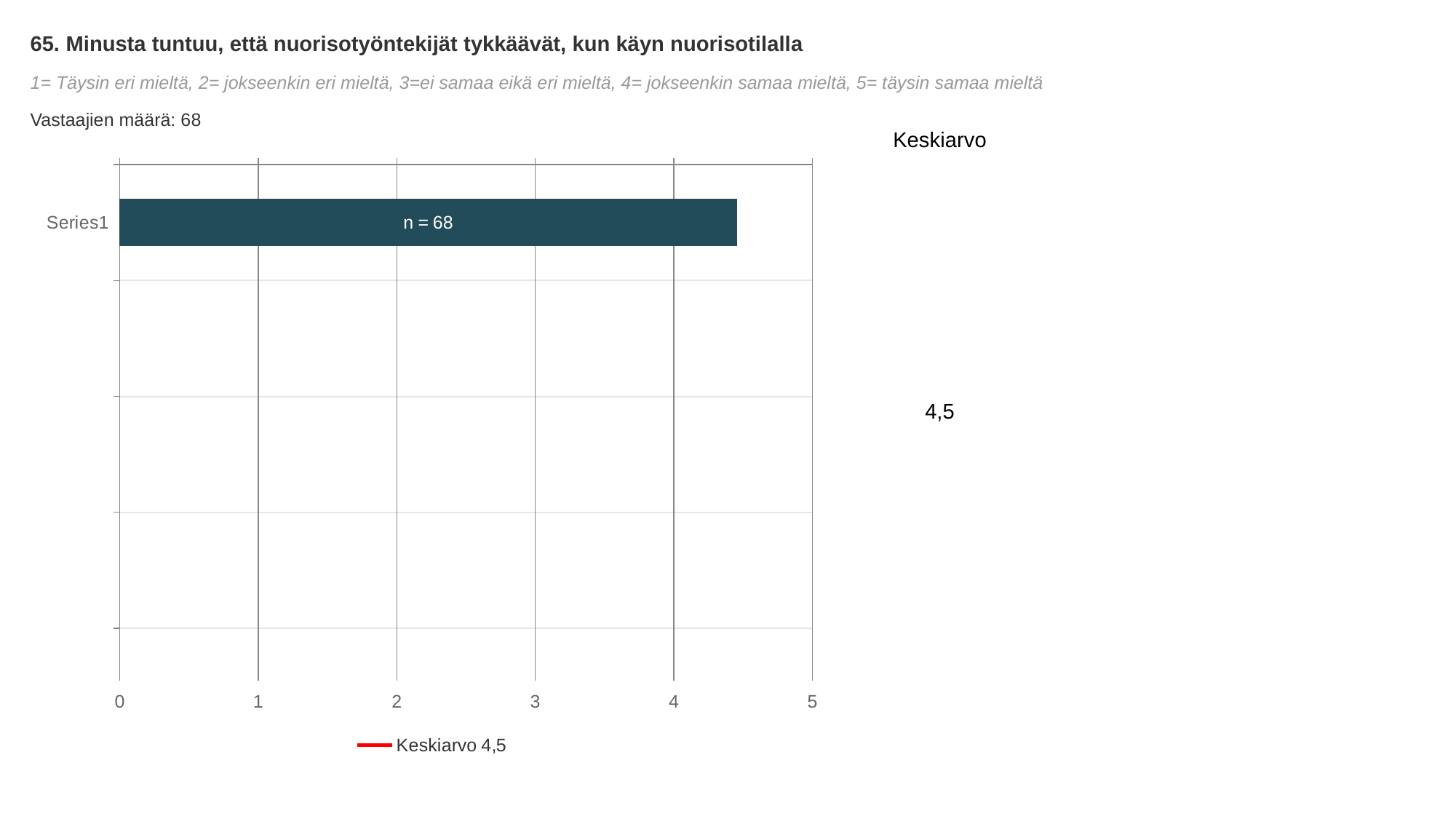
What is the number of respondents (Vastaajien määrä) stated on the slide? 68 What kind of chart is shown on the slide? bar chart Is the value of the Series1 bar greater or less than 3? greater How many entries does the legend list? 1 What text does the legend entry show? Keskiarvo 4,5 What is the Keskiarvo (mean) value shown on the slide? 4,5 What is the highest value shown on the x axis? 5 Is the value of the Series1 bar greater or less than 5? less What data label is printed on the Series1 bar? n = 68 How many bars are plotted in the chart? 1 Is the value of the Series1 bar greater or less than 4? greater